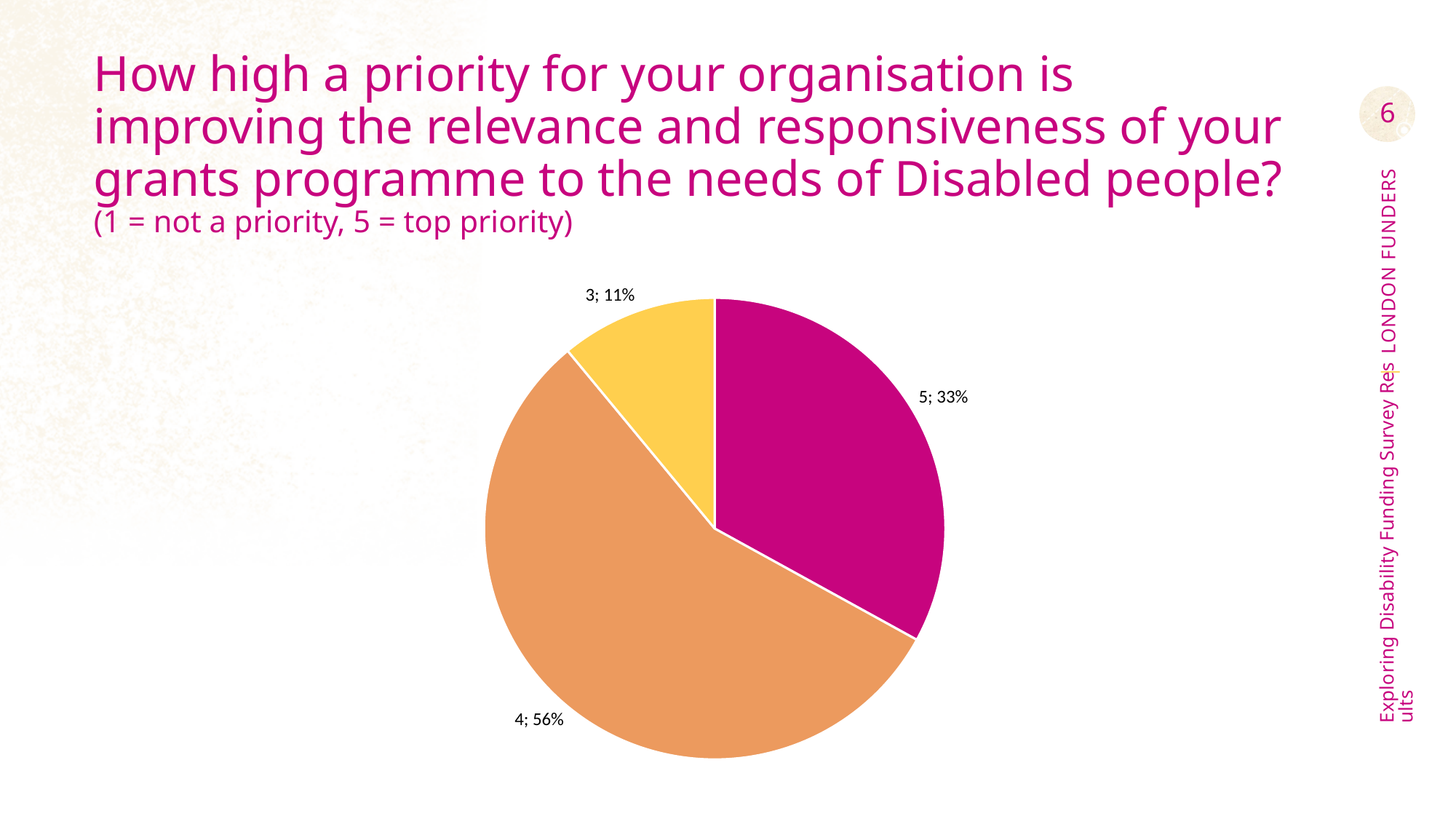
Which rating has the largest slice of the pie? 4 What share of the pie does the rating 4 slice represent? 56% Which rating has the smallest slice of the pie? 3 What kind of chart is shown on the slide? pie chart How many slices does the pie chart have? 3 What share of the pie does the rating 5 slice represent? 33% What is the difference in percentage points between the rating 4 slice and the rating 5 slice? 23 What is the difference in percentage points between the rating 5 slice and the rating 3 slice? 22 Is the share for rating 4 greater or less than 50%? greater What colour is the rating 5 slice of the pie? magenta What share of the pie does the rating 3 slice represent? 11% Which slice is larger, rating 5 or rating 3? 5